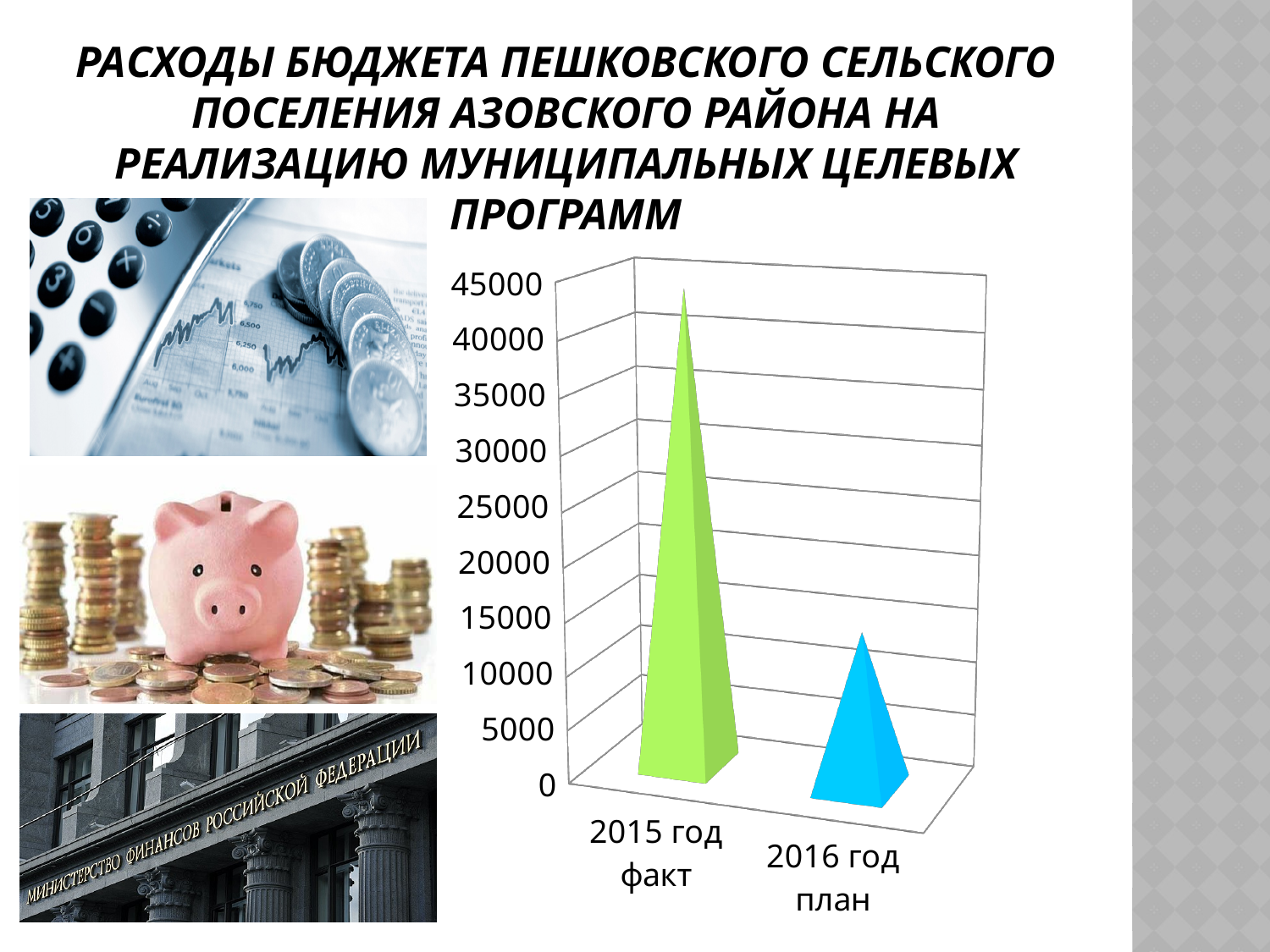
Which category has the lowest value on the chart? 2016 год план What kind of chart is shown on the slide? bar chart Do the values rise or fall from 2015 год факт to 2016 год план? fall Which is larger, the value for 2015 год факт or the value for 2016 год план? 2015 год факт What is the highest value shown on the vertical axis of the chart? 45000 Is the value for 2016 год план greater or less than 20000? less Which category has the highest value on the chart? 2015 год факт Is the value for 2015 год факт greater or less than 35000? greater Is the value for 2016 год план greater or less than 5000? greater What colour is the bar for 2016 год план? blue How many categories are plotted on the chart? 2